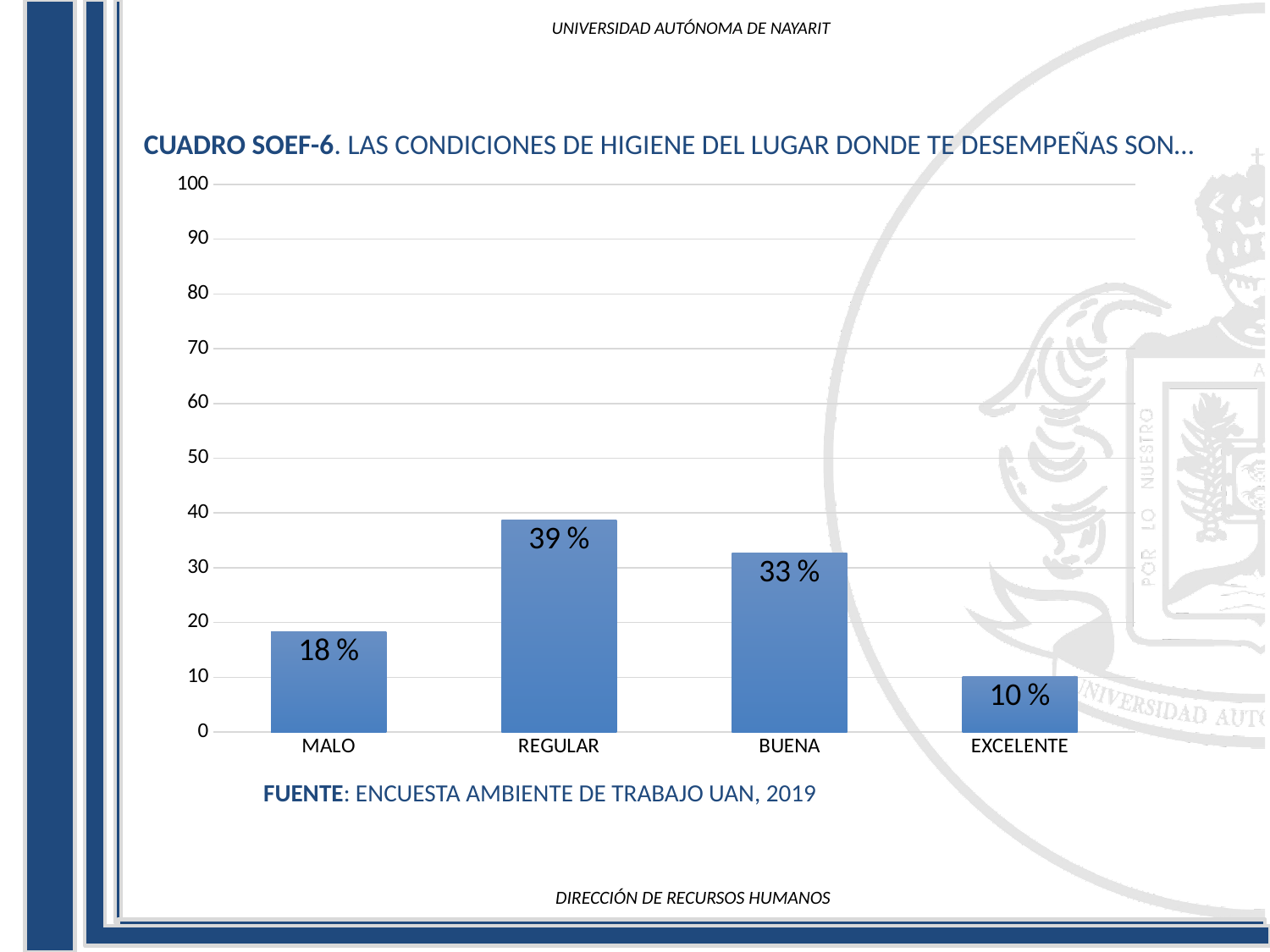
What is the value for REGULAR? 39 % Is the value for BUENA greater or less than 40? less What is the value for EXCELENTE? 10 % How many categories are shown on the x axis? 4 What is the value for BUENA? 33 % What kind of chart is shown on the slide? bar chart What source is cited below the chart? ENCUESTA AMBIENTE DE TRABAJO UAN, 2019 What is the difference between the values for REGULAR and BUENA? 6 % Which category has the highest value? REGULAR Which category has the lowest value? EXCELENTE Which is larger, the value for MALO or the value for EXCELENTE? MALO What is the value for MALO? 18 %